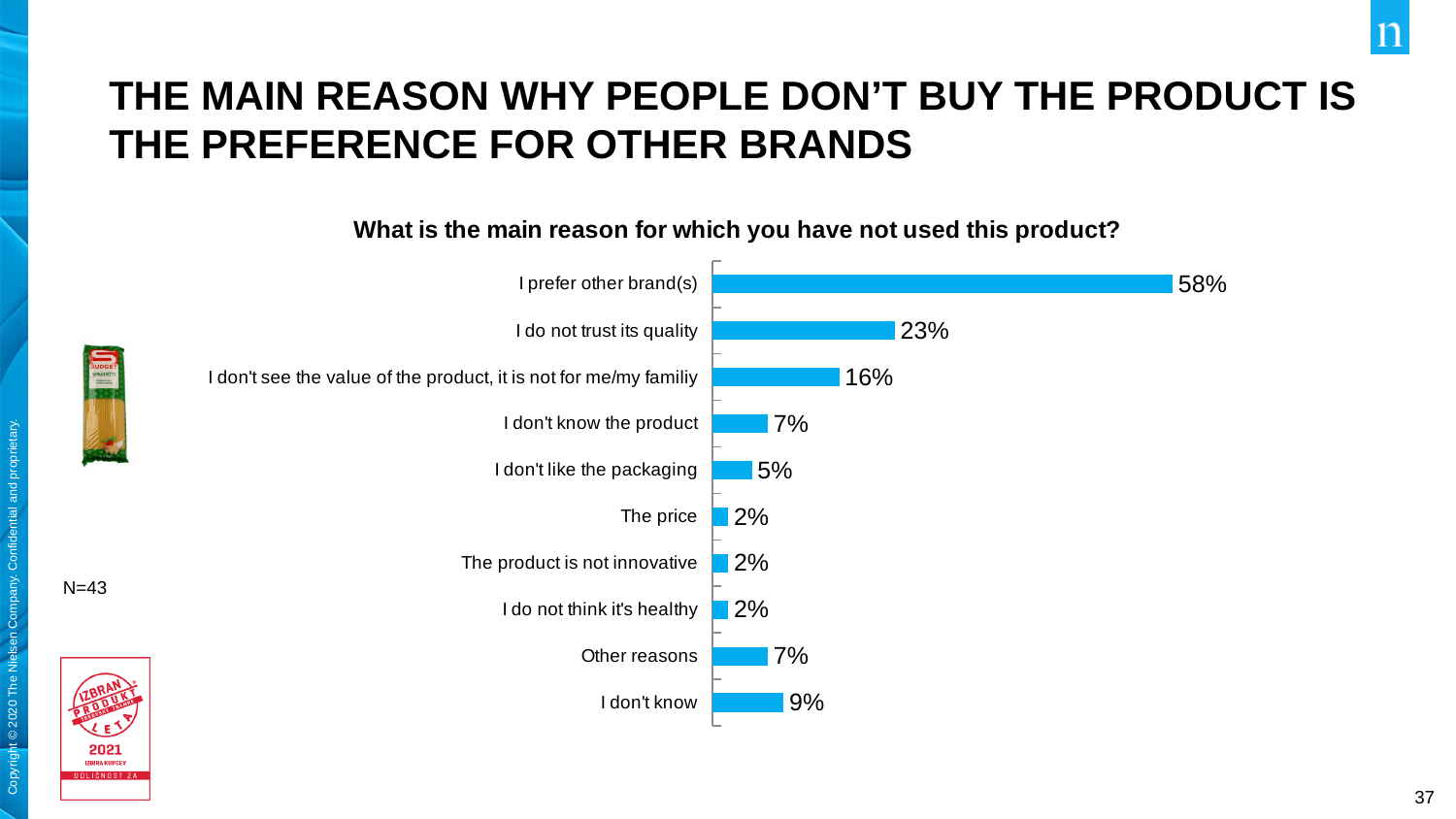
Which is larger, the value for 'I don't know' or the value for 'Other reasons'? I don't know Which reason has the highest percentage? I prefer other brand(s) What percentage chose 'I don't like the packaging'? 5% What is the value for 'I do not trust its quality'? 23% How many reasons (categories) are shown in the chart? 10 What is the value for 'I don't know'? 9% Which is larger, 'I do not trust its quality' or 'I don't see the value of the product, it is not for me/my familiy'? I do not trust its quality What is the sample size (N) shown on the slide? N=43 What is the difference between 'I prefer other brand(s)' and 'I do not trust its quality'? 35 percentage points What percentage of respondents said 'I prefer other brand(s)' as the main reason for not using the product? 58% What is the difference between 'I don't see the value of the product, it is not for me/my familiy' and 'I don't know the product'? 9 percentage points What type of chart is shown on the slide? Bar chart